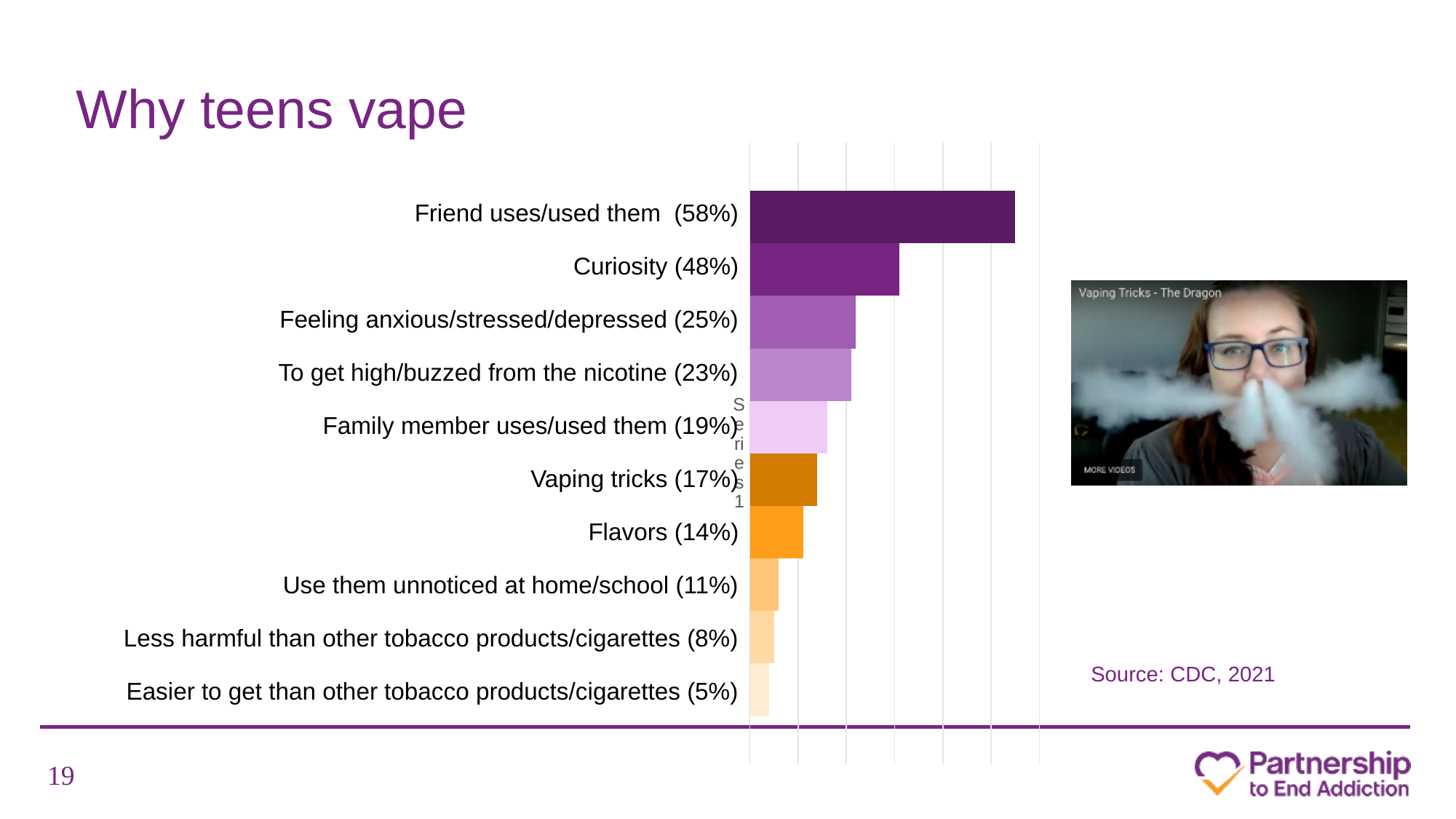
What percentage is shown for 'Flavors'? 14% Which reason for vaping has the highest percentage? Friend uses/used them Which reason for vaping has the lowest percentage? Easier to get than other tobacco products/cigarettes What percentage of teens cited 'Friend uses/used them' as a reason for vaping? 58% Which has a higher percentage: 'Feeling anxious/stressed/depressed' or 'To get high/buzzed from the nicotine'? Feeling anxious/stressed/depressed What is the difference in percentage points between 'Friend uses/used them' and 'Curiosity'? 10 How many reasons for vaping are listed in the chart? 10 What type of chart is used on this slide? Bar chart What is the difference in percentage points between 'Vaping tricks' and 'Flavors'? 3 Which has a higher percentage: 'Family member uses/used them' or 'Use them unnoticed at home/school'? Family member uses/used them What percentage is shown for 'Curiosity'? 48% What percentage is shown for 'Easier to get than other tobacco products/cigarettes'? 5%